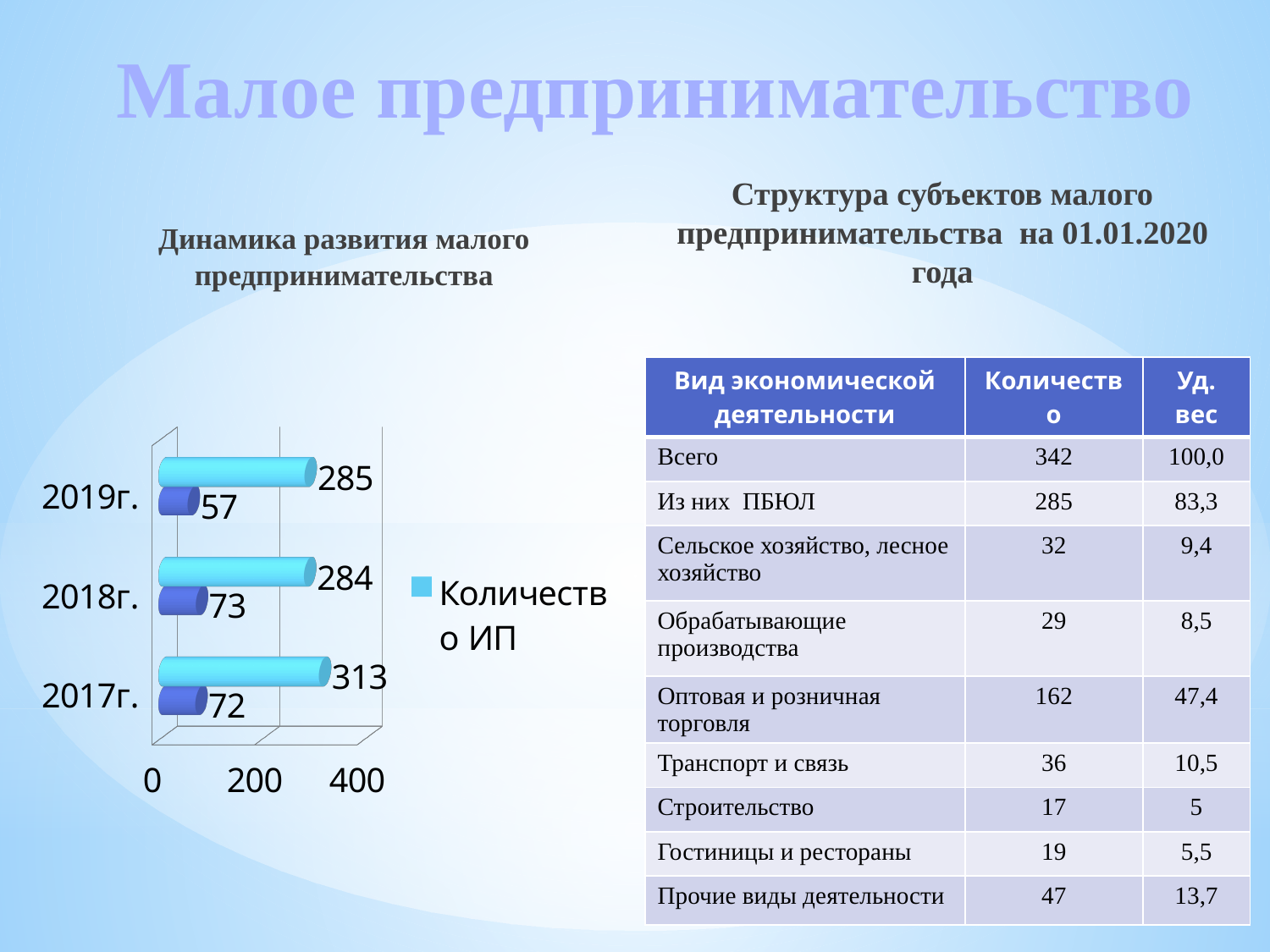
How many years are shown in the chart 'Динамика развития малого предпринимательства'? 3 What kind of chart is 'Динамика развития малого предпринимательства'? bar chart In the chart 'Динамика развития малого предпринимательства', which year has the highest value of Количество ИП? 2017г. In the chart 'Динамика развития малого предпринимательства', which is larger: Количество ИП for 2017г. or for 2018г.? 2017г. In the chart 'Динамика развития малого предпринимательства', what is the value of Количество ИП for 2019г.? 285 How many entries does the legend of the chart 'Динамика развития малого предпринимательства' list? 1 In the chart 'Динамика развития малого предпринимательства', what is the value of Количество ИП for 2017г.? 313 In the chart 'Динамика развития малого предпринимательства', what value is printed on the dark blue bar for 2018г.? 73 In the chart 'Динамика развития малого предпринимательства', is the value of Количество ИП for 2017г. greater or less than 200? greater In the chart 'Динамика развития малого предпринимательства', what is the difference between the dark blue bar values for 2018г. and 2019г.? 16 In the chart 'Динамика развития малого предпринимательства', what is the difference between Количество ИП for 2017г. and 2019г.? 28 In the chart 'Динамика развития малого предпринимательства', which year has the lowest value on the dark blue bar? 2019г.